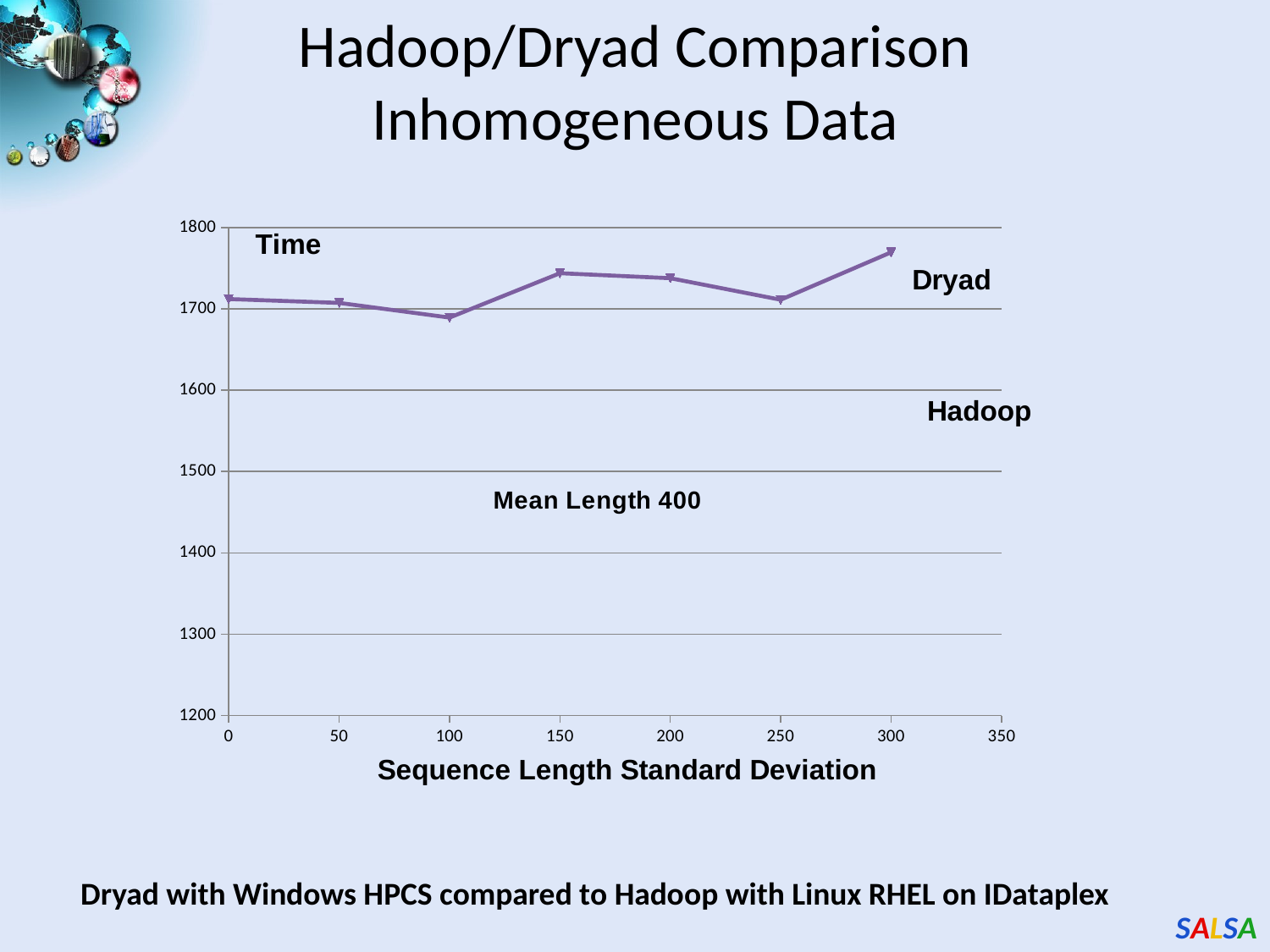
How many data points are plotted on the Dryad line? 7 At which sequence length standard deviation is the Dryad time highest? 300 Which has the larger Dryad time: a standard deviation of 300 or a standard deviation of 100? 300 Is the Dryad time at a standard deviation of 150 greater or less than 1800? less Is the Dryad time at a standard deviation of 300 greater or less than 1700? greater What kind of chart is shown on the slide? line chart Between standard deviations of 50 and 100, does the Dryad line rise or fall? fall What mean length is stated in the annotation on the chart? Mean Length 400 What is the title of the x axis of the chart? Sequence Length Standard Deviation Between standard deviations of 250 and 300, does the Dryad line rise or fall? rise Is the Dryad time at a standard deviation of 100 greater or less than 1700? less At which sequence length standard deviation is the Dryad time lowest? 100